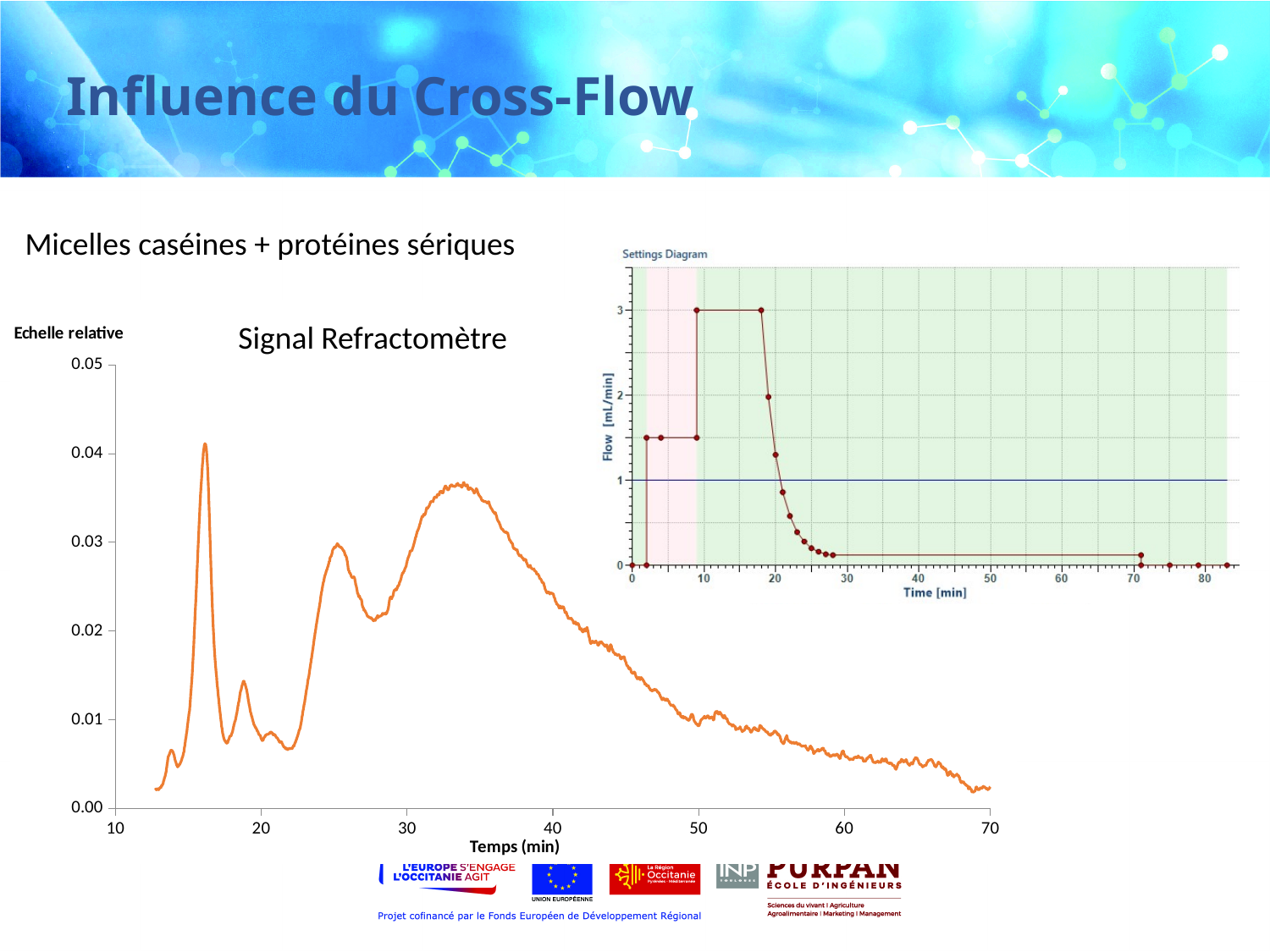
On the 'Settings Diagram' chart, what is the maximum flow value reached? 3 On the 'Signal Refractomètre' chart, what is the label of the x axis? Temps (min) On the 'Settings Diagram' chart, what is the flow value between 10 and 18 min? 3 On the 'Signal Refractomètre' chart, which is higher: the peak near 16 min or the peak near 34 min? the peak near 16 min On the 'Settings Diagram' chart, does the flow rise or fall between 18 min and 28 min? fall On the 'Settings Diagram' chart, what is the label of the y axis? Flow [mL/min] What kind of chart is the 'Signal Refractomètre' chart? line chart On the 'Signal Refractomètre' chart, is the value at 25 min greater or less than 0.02? greater On the 'Signal Refractomètre' chart, is the value of the peak near 16 min greater or less than 0.03? greater On the 'Signal Refractomètre' chart, is the value at 60 min greater or less than 0.01? less On the 'Signal Refractomètre' chart, does the signal rise or fall between 40 min and 70 min? fall